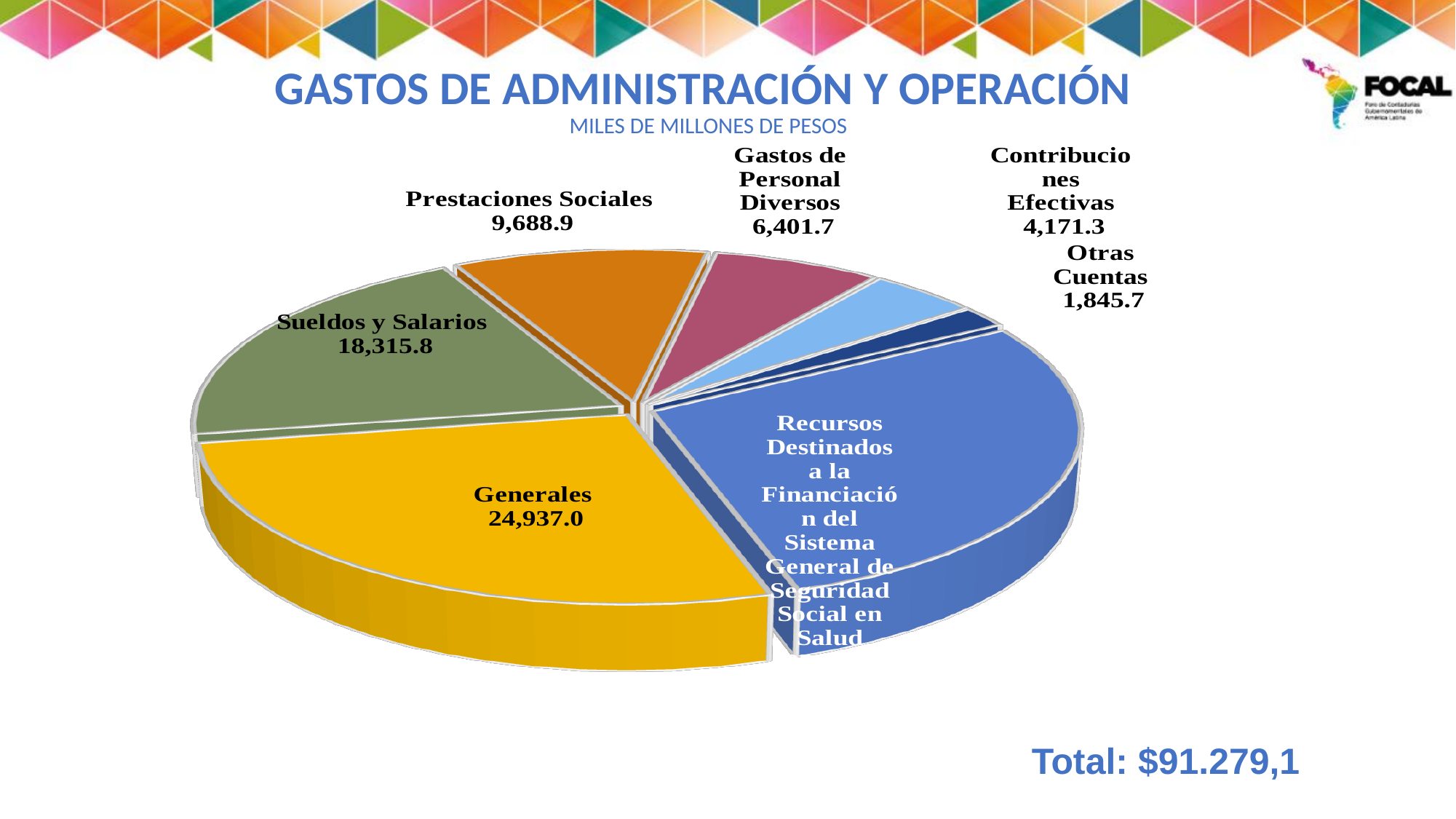
What is the value for Prestaciones Sociales? 9,688.9 What is the value for Contribuciones Efectivas? 4,171.3 What is the difference between Generales and Sueldos y Salarios? 6,621.2 Which category has the smallest slice in the pie chart? Otras Cuentas How many slices does the pie chart have? 7 What is the value for Sueldos y Salarios? 18,315.8 What is the difference between Contribuciones Efectivas and Otras Cuentas? 2,325.6 What unit is stated under the chart title? Miles de millones de pesos What is the value for Generales? 24,937.0 What is the value for Gastos de Personal Diversos? 6,401.7 What kind of chart is shown on the slide? Pie chart Which is larger, Prestaciones Sociales or Gastos de Personal Diversos? Prestaciones Sociales